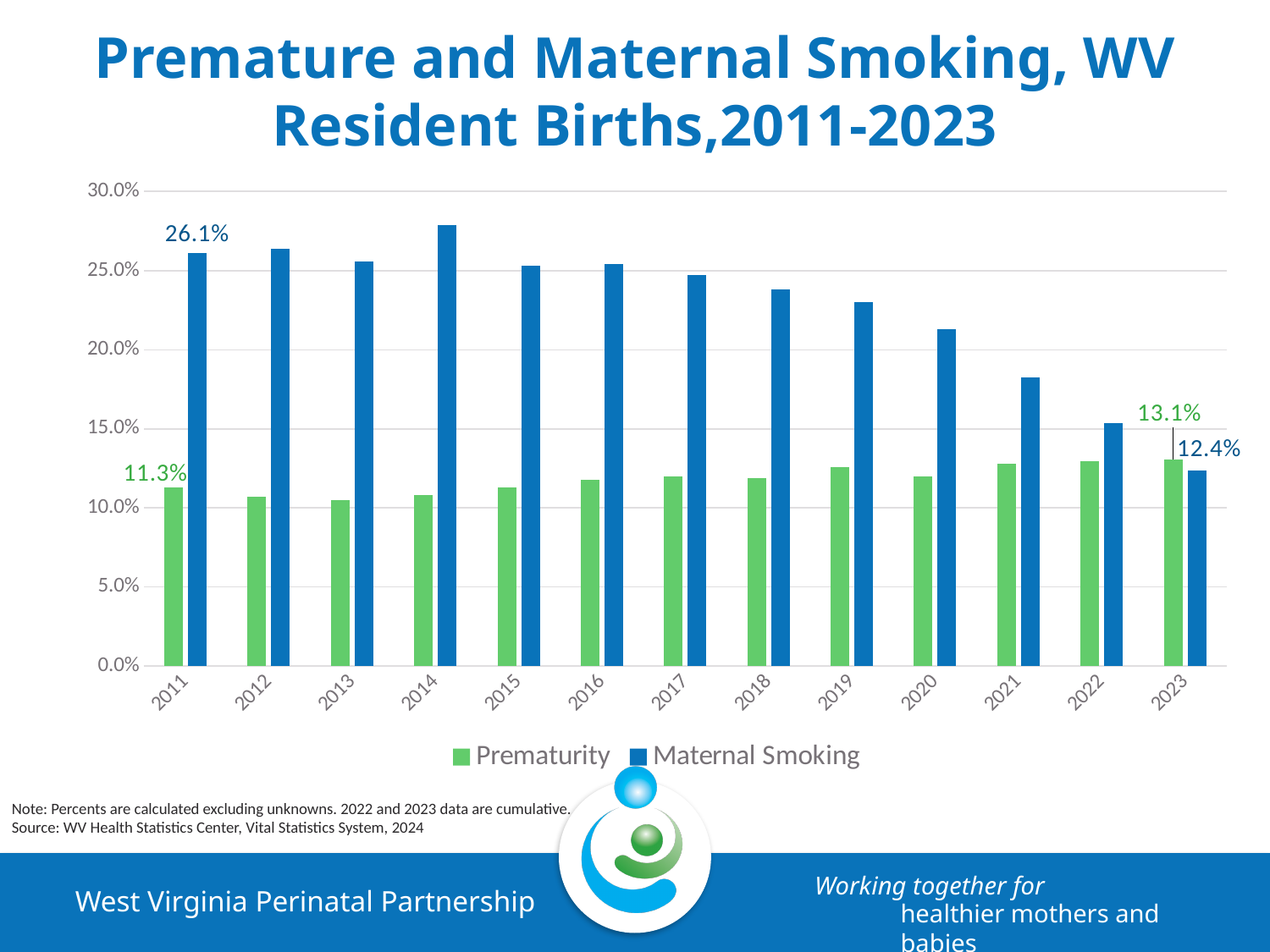
What is the Prematurity value for 2011? 11.3% By how many percentage points did Maternal Smoking fall from 2011 to 2023? 13.7 percentage points Which year has the lowest Maternal Smoking value? 2023 How many series does the legend list? 2 In 2023, which is larger, Prematurity or Maternal Smoking? Prematurity Is the Maternal Smoking value for 2021 greater or less than 20.0%? less What is the Maternal Smoking value for 2011? 26.1% Which year has the highest Maternal Smoking value? 2014 Does the Maternal Smoking series rise or fall from 2014 to 2023? fall What is the Maternal Smoking value for 2023? 12.4% What is the Prematurity value for 2023? 13.1% How many years are shown on the x axis? 13